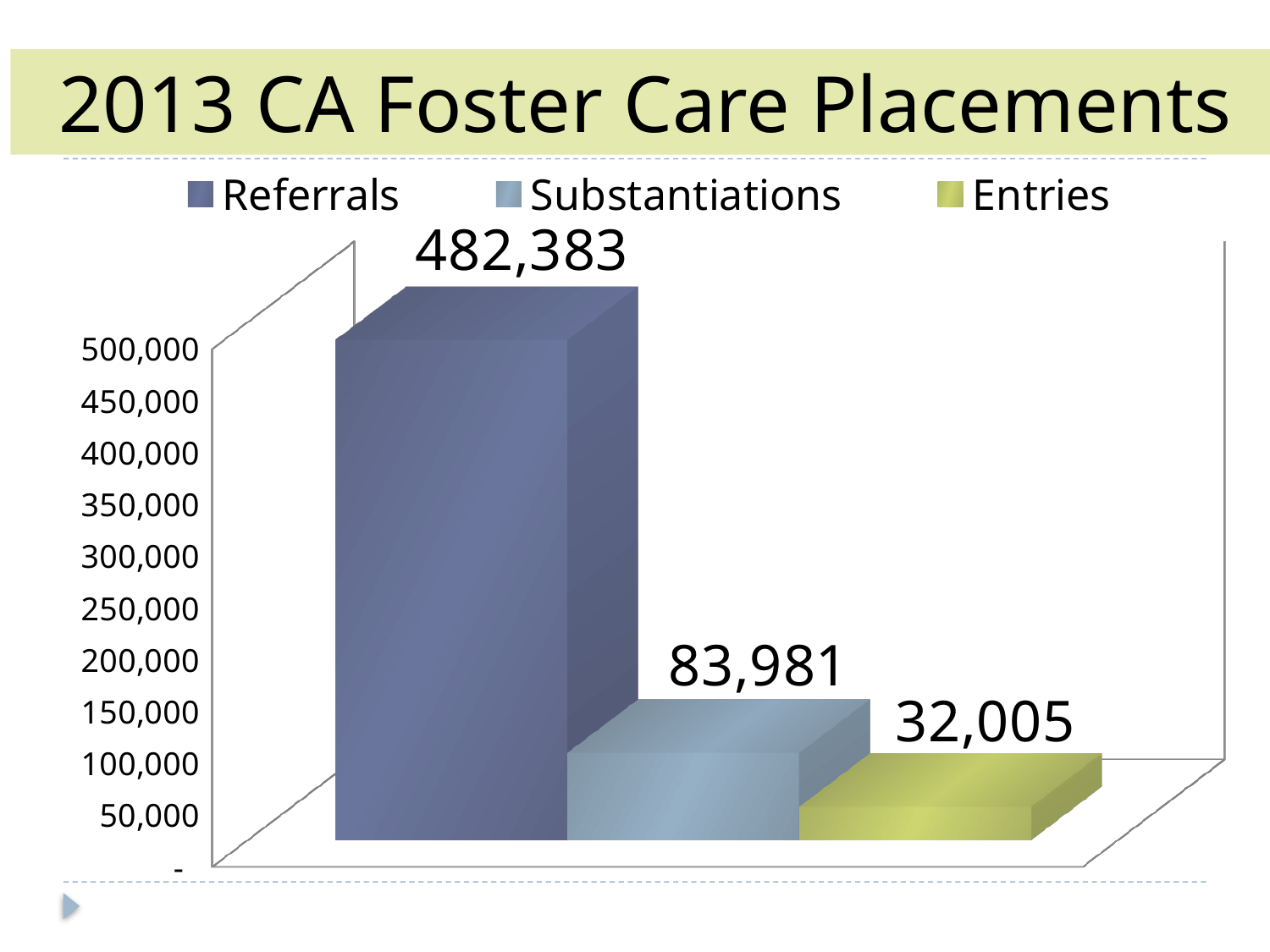
What is the value for Referrals? 482,383 What is the difference between Referrals and Substantiations? 398,402 What is the title of the slide? 2013 CA Foster Care Placements What kind of chart is shown on the slide? Bar chart How many series does the legend list? 3 What is the value for Entries? 32,005 Which series has the highest value? Referrals Is the value for Referrals greater or less than 450,000? greater What is the value for Substantiations? 83,981 Which series has the lowest value? Entries What is the difference between Substantiations and Entries? 51,976 Which is larger, Substantiations or Entries? Substantiations